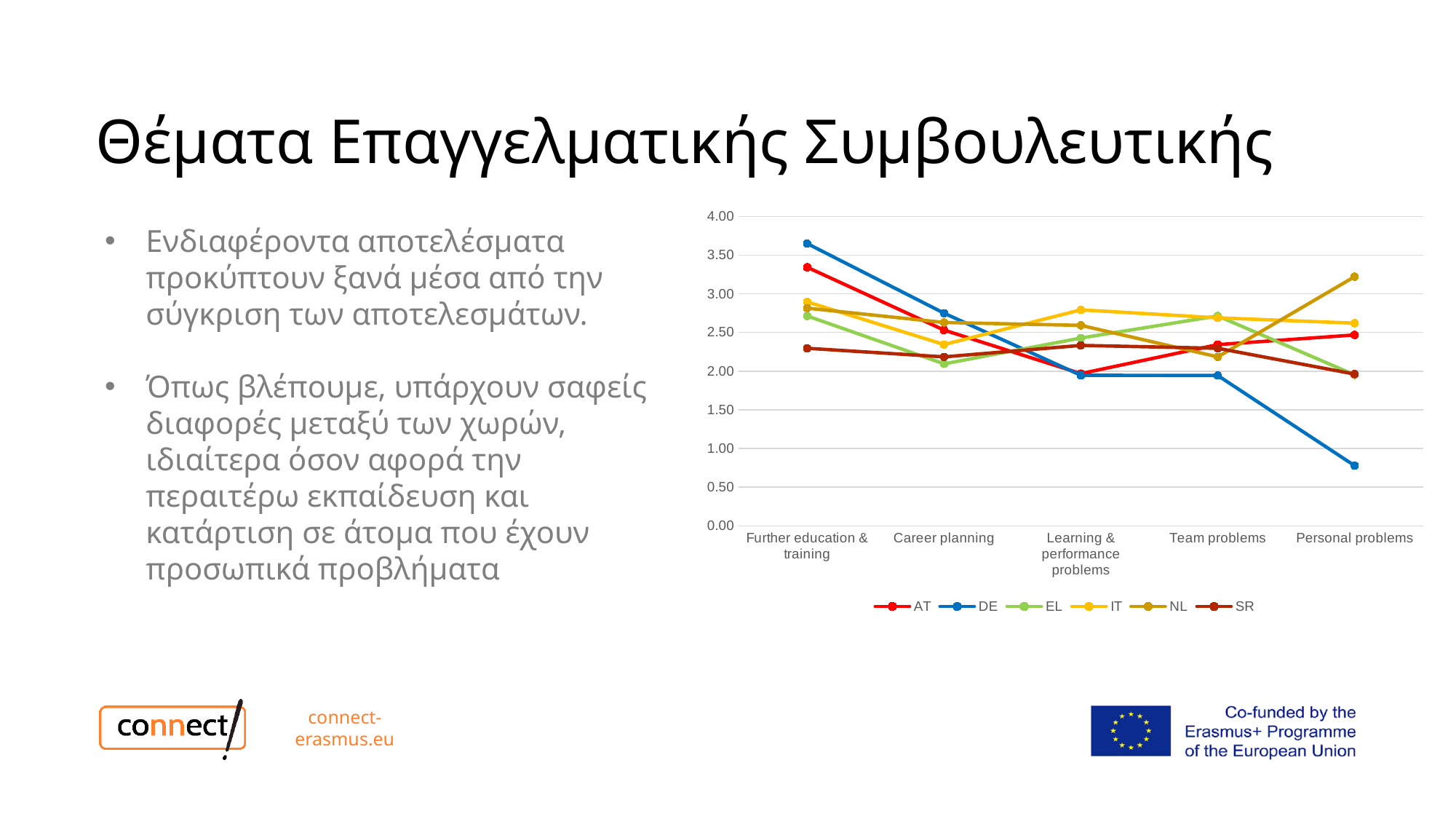
Which series has the lowest value for Further education & training? SR How many categories are shown along the x axis of the chart? 5 Which series has the highest value for Personal problems? NL Which series has the lowest value for Personal problems? DE Is the value for DE at Personal problems greater or less than 1.00? less What colour is the DE line in the chart? blue Which is larger at Further education & training, the value for AT or the value for SR? AT What kind of chart is shown on the slide? line chart Is the value for DE at Further education & training greater or less than 3.50? greater How many series does the legend of the chart list? 6 Does the DE line rise or fall overall from Further education & training to Personal problems? fall Which series has the highest value for Further education & training? DE